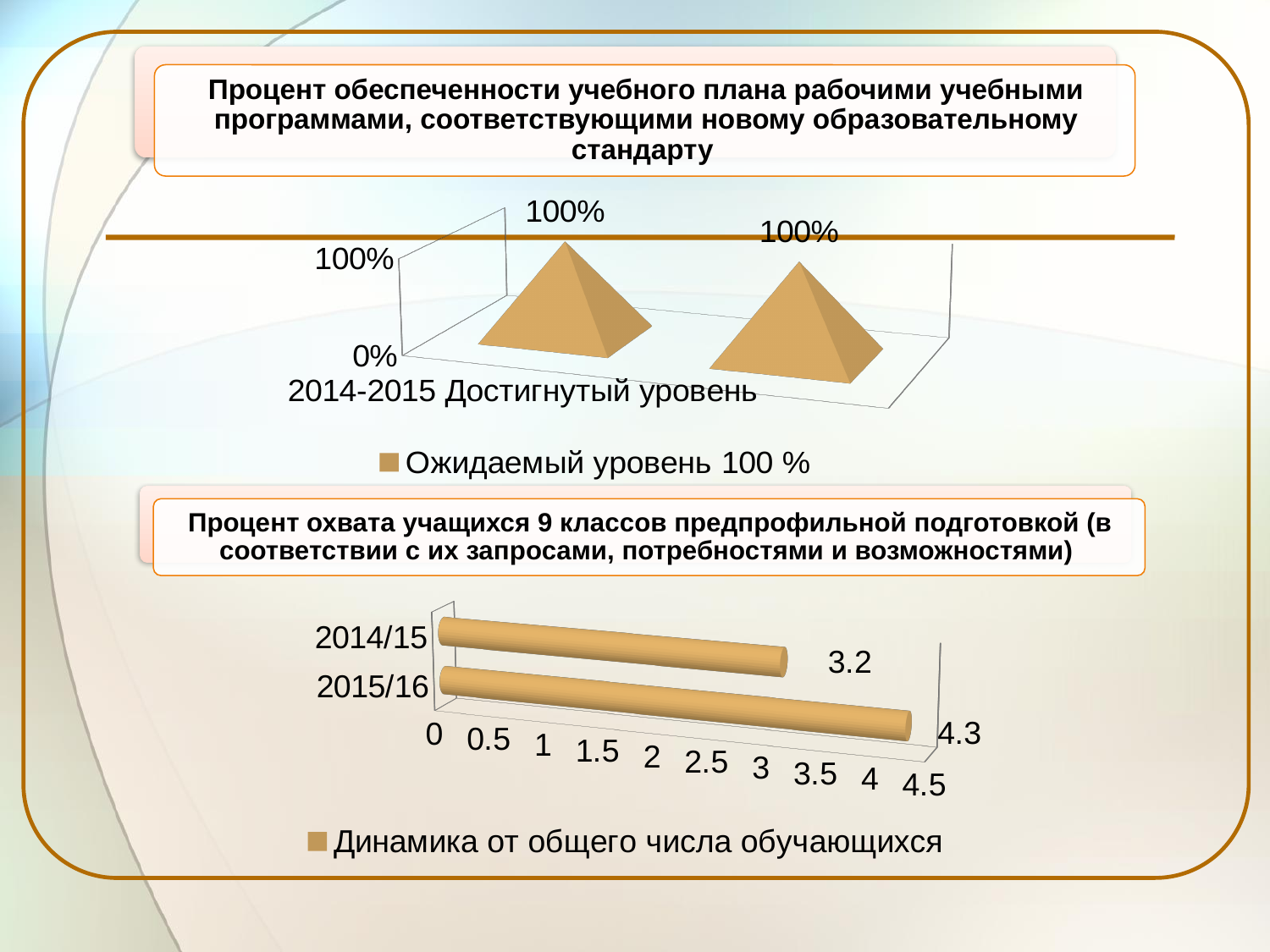
In the bottom chart, how many categories are shown? 2 In the top chart, what series name does the legend show? Ожидаемый уровень 100 % In the bottom chart, what is the value for 2014/15? 3.2 In the top chart, what value is labelled on each of the two pyramids? 100% In the bottom chart, is the value for 2014/15 greater or less than 3.5? less In the bottom chart, which category has the lower value? 2014/15 In the bottom chart, what is the difference between the values for 2015/16 and 2014/15? 1.1 In the bottom chart, what series name does the legend show? Динамика от общего числа обучающихся In the bottom chart, do the values rise or fall from 2014/15 to 2015/16? rise What kind of chart is the bottom chart? bar chart In the bottom chart, which category has the higher value? 2015/16 In the bottom chart, what is the value for 2015/16? 4.3